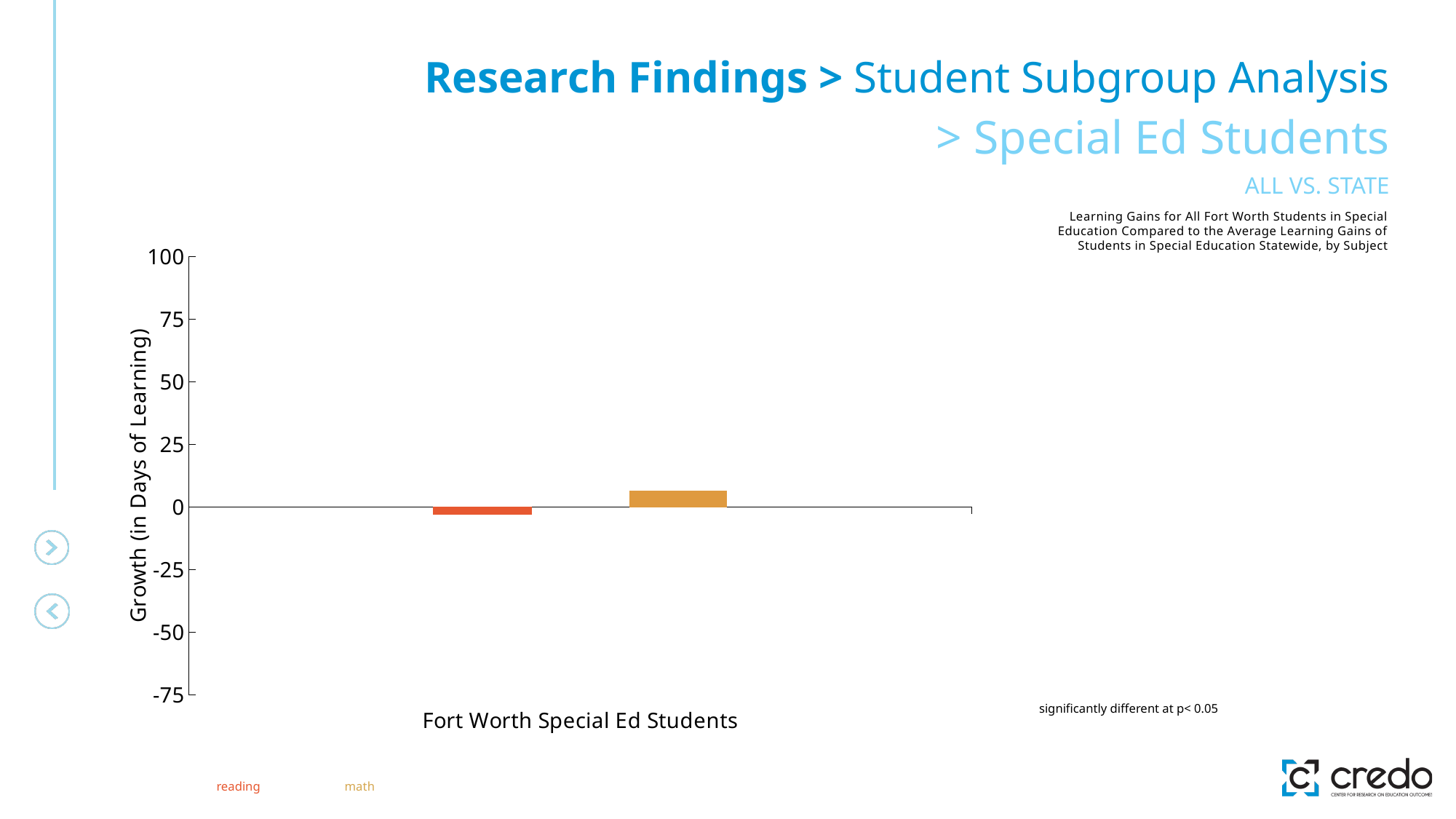
Is the value for reading greater or less than -25? greater How many series does the legend list? 2 Which series shows the lowest growth for Fort Worth Special Ed Students? reading Is the value for math greater or less than 0? greater How many categories are shown on the x axis? 1 Is the value for reading greater or less than 0? less What kind of chart is shown on the slide? bar chart Which series has the higher value for Fort Worth Special Ed Students, reading or math? math What is the category label on the x axis? Fort Worth Special Ed Students What is the label on the y axis? Growth (in Days of Learning)